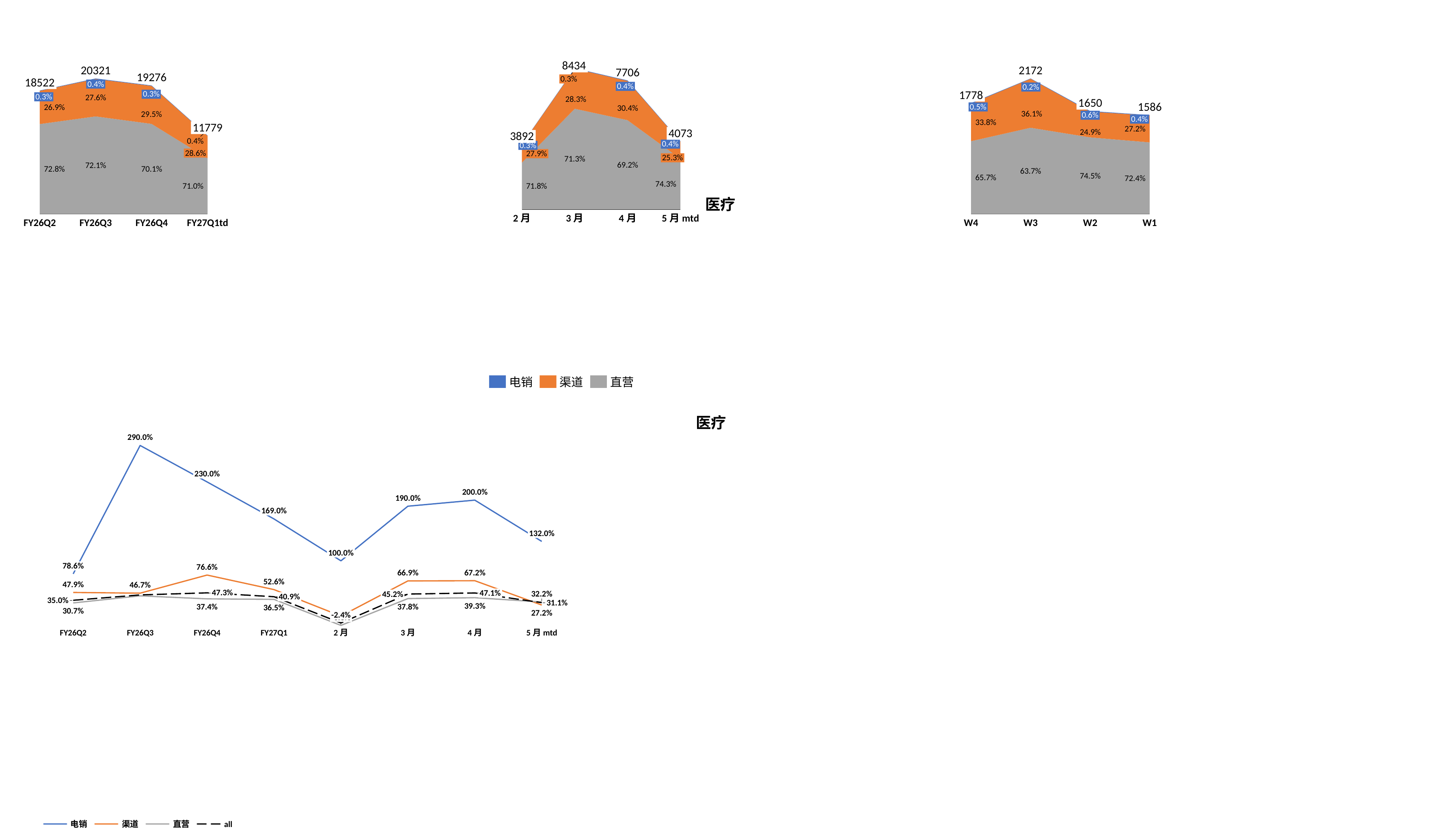
In the top-left chart (FY26Q2 to FY27Q1td), which period has the lowest total? FY27Q1td In the top-middle chart (2月 to 5月 mtd), what is the difference between the totals for 3月 and 4月? 728 In the top-middle chart (2月 to 5月 mtd), what share does 渠道 have in 5月 mtd? 25.3% In the bottom line chart titled 医疗, what is the 电销 value at FY26Q3? 290.0% In the top-middle chart (2月 to 5月 mtd), what is the total value for 3月? 8434 In the top-right chart (W4 to W1), which week has the highest total? W3 In the bottom line chart titled 医疗, how many series does the legend list? 4 In the bottom line chart titled 医疗, what is the 渠道 value at FY26Q4? 76.6% In the top-left chart (FY26Q2 to FY27Q1td), what is the total value shown for FY26Q3? 20321 In the top-right chart (W4 to W1), what share does 渠道 have in W2? 24.9% In the top-right chart (W4 to W1), is the total for W2 larger or smaller than the total for W1? larger In the top-left chart (FY26Q2 to FY27Q1td), what share does 直营 have in FY26Q4? 70.1%